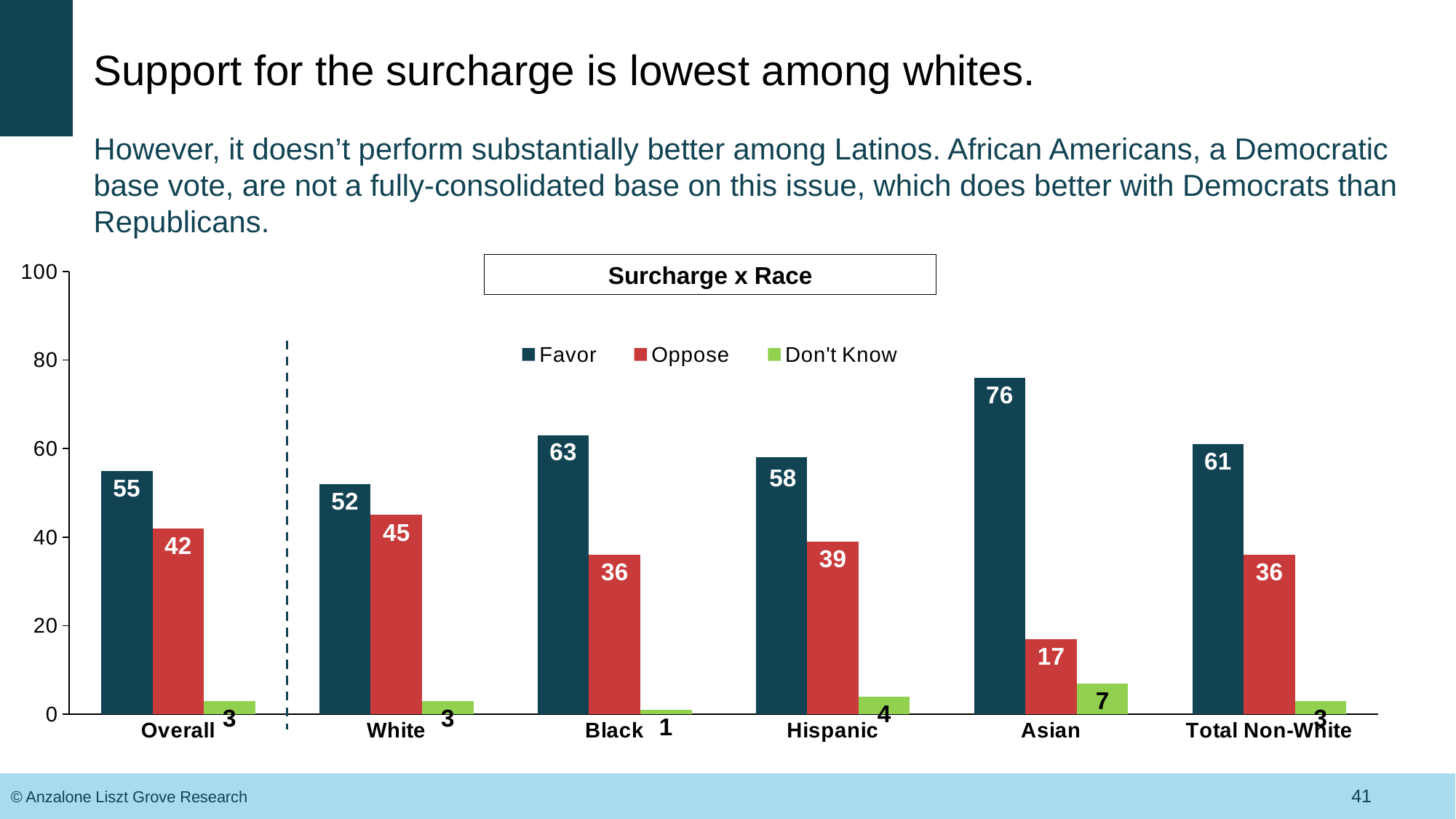
Which category has the lowest Oppose value? Asian What is the Don't Know value for Hispanic? 4 How many series does the legend list? 3 What is the Oppose value for White? 45 Which is larger, the Favor value for Hispanic or the Favor value for Total Non-White? Total Non-White What is the title of the chart? Surcharge x Race What kind of chart is shown on the slide? bar chart What is the Favor value for Asian? 76 Is the Oppose value for Hispanic greater or less than 40? less What is the difference between the Favor and Oppose values for Black? 27 Which category has the highest Favor value? Asian How many categories are shown on the x axis? 6